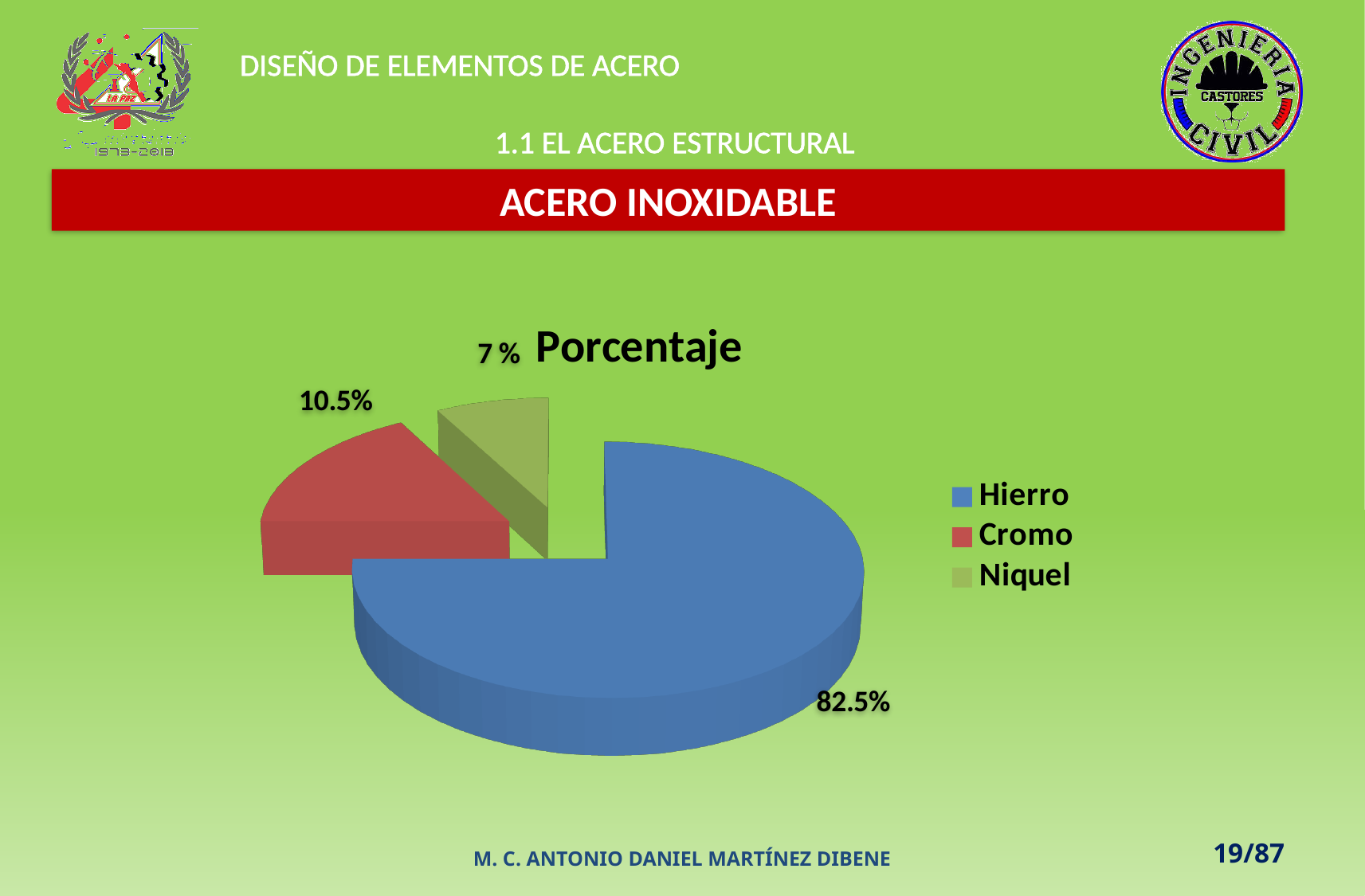
What percentage does the Cromo slice show? 10.5% What colour is the Hierro slice in the legend? blue How many slices does the pie chart have? 3 What percentage does the Hierro slice show? 82.5% Which is larger, the Cromo slice or the Niquel slice? Cromo How many entries does the legend list? 3 What is the title of the chart? Porcentaje What percentage does the Niquel slice show? 7 % Which category has the smallest slice of the pie? Niquel What is the difference between the Hierro and Cromo percentages? 72% Which category has the largest slice of the pie? Hierro What kind of chart is shown on the slide? pie chart